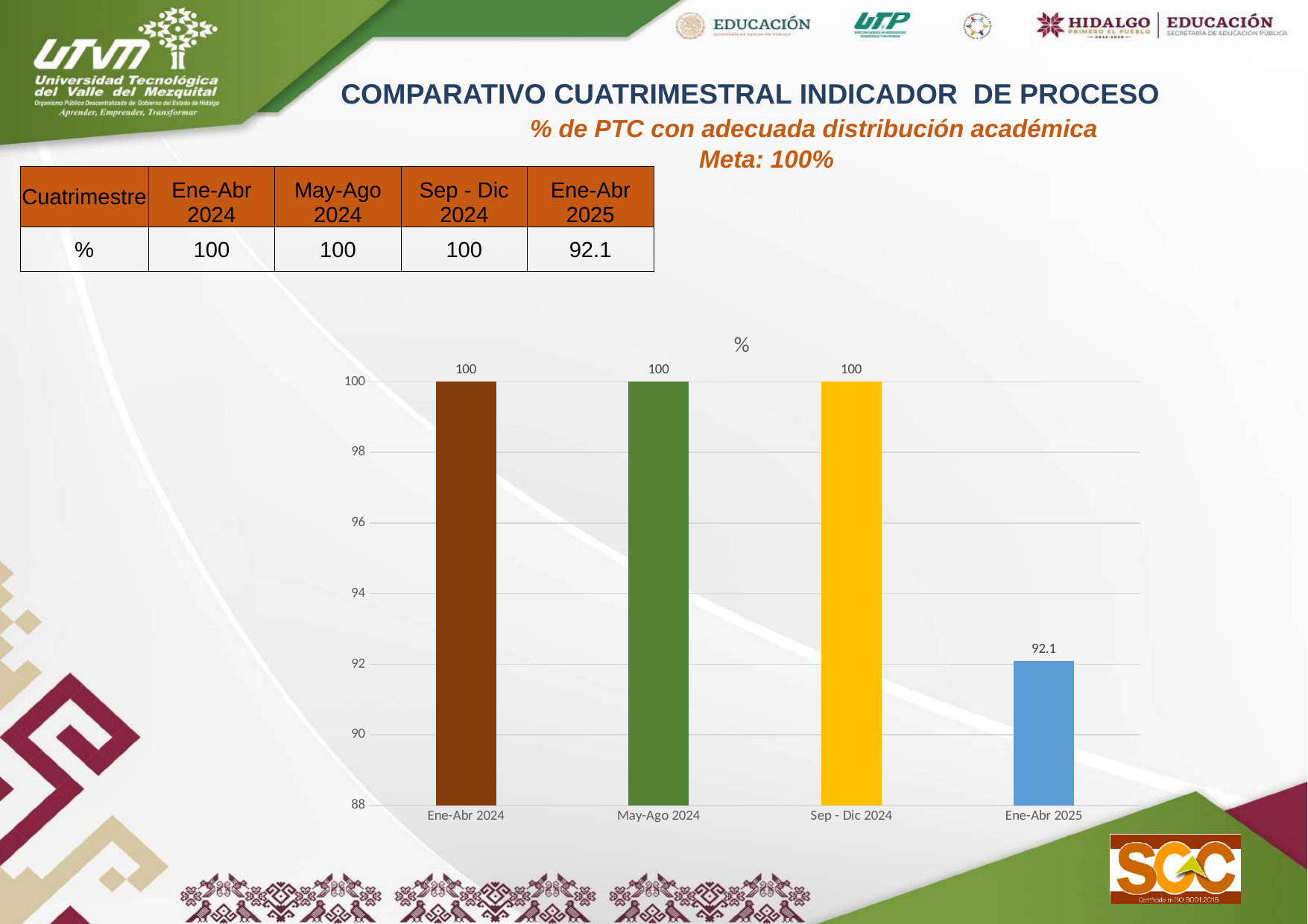
Which category has the lowest value in the chart? Ene-Abr 2025 What is the difference between the values for Sep - Dic 2024 and Ene-Abr 2025? 7.9 Which is larger, the value for Ene-Abr 2024 or the value for Ene-Abr 2025? Ene-Abr 2024 What is the value for Sep - Dic 2024 in the chart? 100 Do the values rise, fall or stay flat from Sep - Dic 2024 to Ene-Abr 2025? fall What is the title of the chart? % What is the value for May-Ago 2024 in the chart? 100 What is the value for Ene-Abr 2025 in the chart? 92.1 What colour is the bar for Ene-Abr 2025? blue How many categories are shown on the x axis of the chart? 4 Is the value for Ene-Abr 2025 greater or less than 94? less What kind of chart is shown on the slide? bar chart